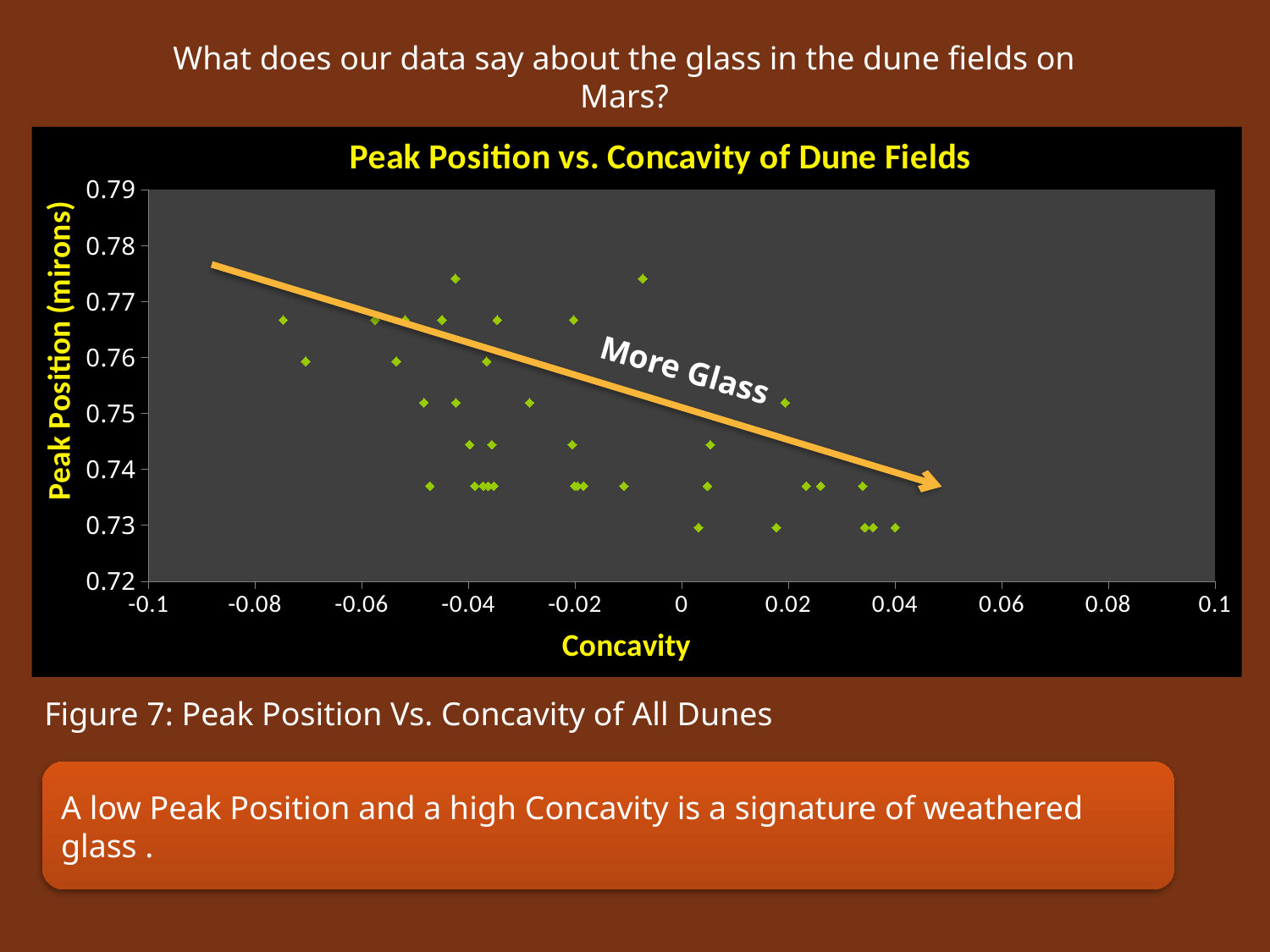
Is the smallest concavity value plotted on the chart greater or less than -0.08? greater Is the highest peak position plotted on the chart greater or less than 0.78? less Is the lowest peak position plotted on the chart greater or less than 0.72? greater Do the plotted peak position values generally rise or fall as concavity increases along the x axis? fall What is the maximum value shown on the y axis of the chart? 0.79 What kind of chart is shown on the slide? scatter chart What is the title of the chart? Peak Position vs. Concavity of Dune Fields What is the label of the x axis of the chart? Concavity